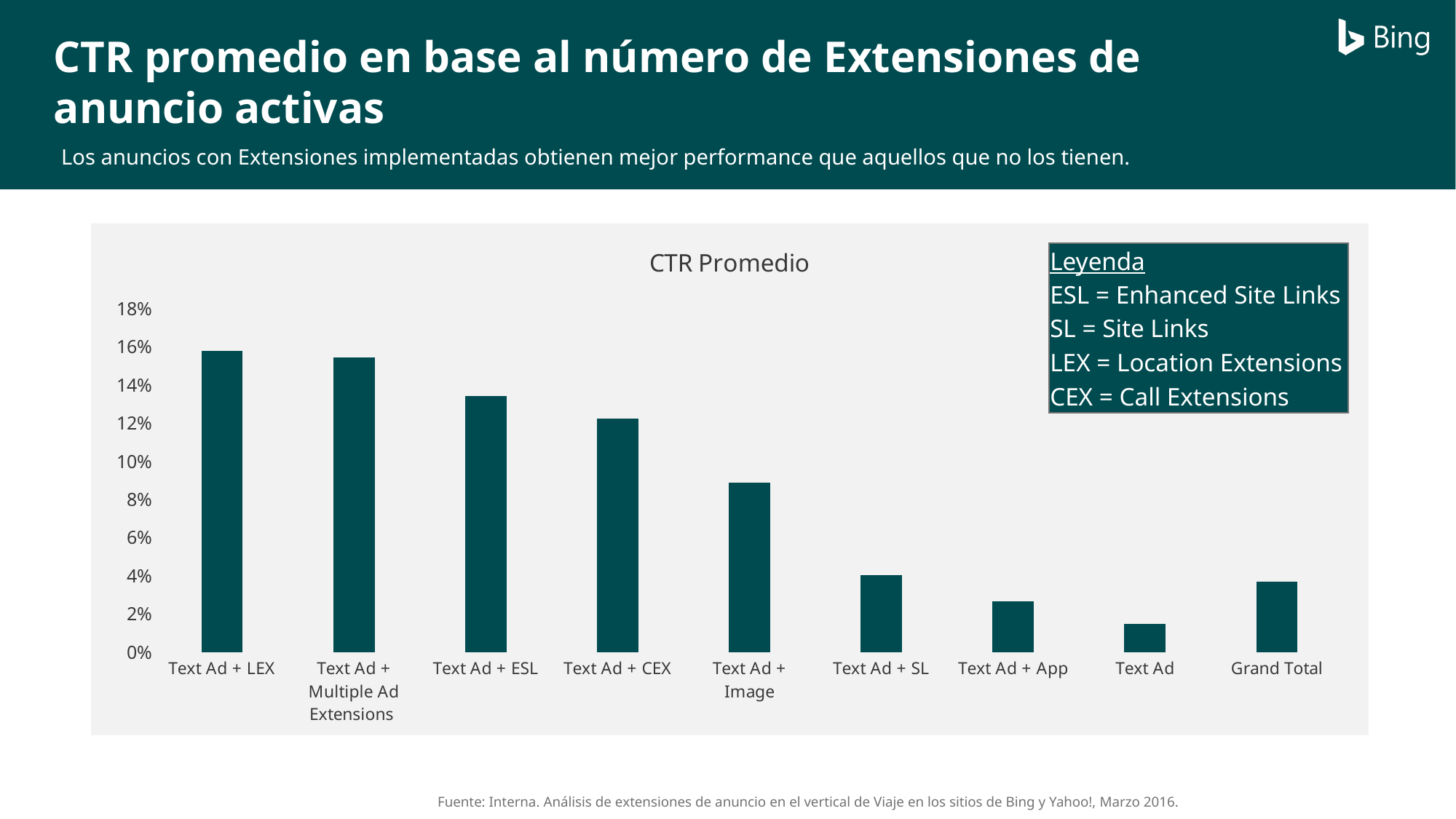
Which is larger, the value for Text Ad + SL or the value for Text Ad + App? Text Ad + SL Which category has the lowest CTR Promedio? Text Ad According to the Leyenda box on the chart, what does LEX stand for? Location Extensions Which is larger, the value for Text Ad + ESL or the value for Text Ad + CEX? Text Ad + ESL What is the title of the chart? CTR Promedio Is the value for Text Ad + LEX greater or less than 14%? greater How many categories are plotted on the x axis of the chart? 9 What kind of chart is shown on the slide? bar chart Is the value for Grand Total greater or less than 6%? less Is the value for Text Ad + CEX greater or less than 10%? greater